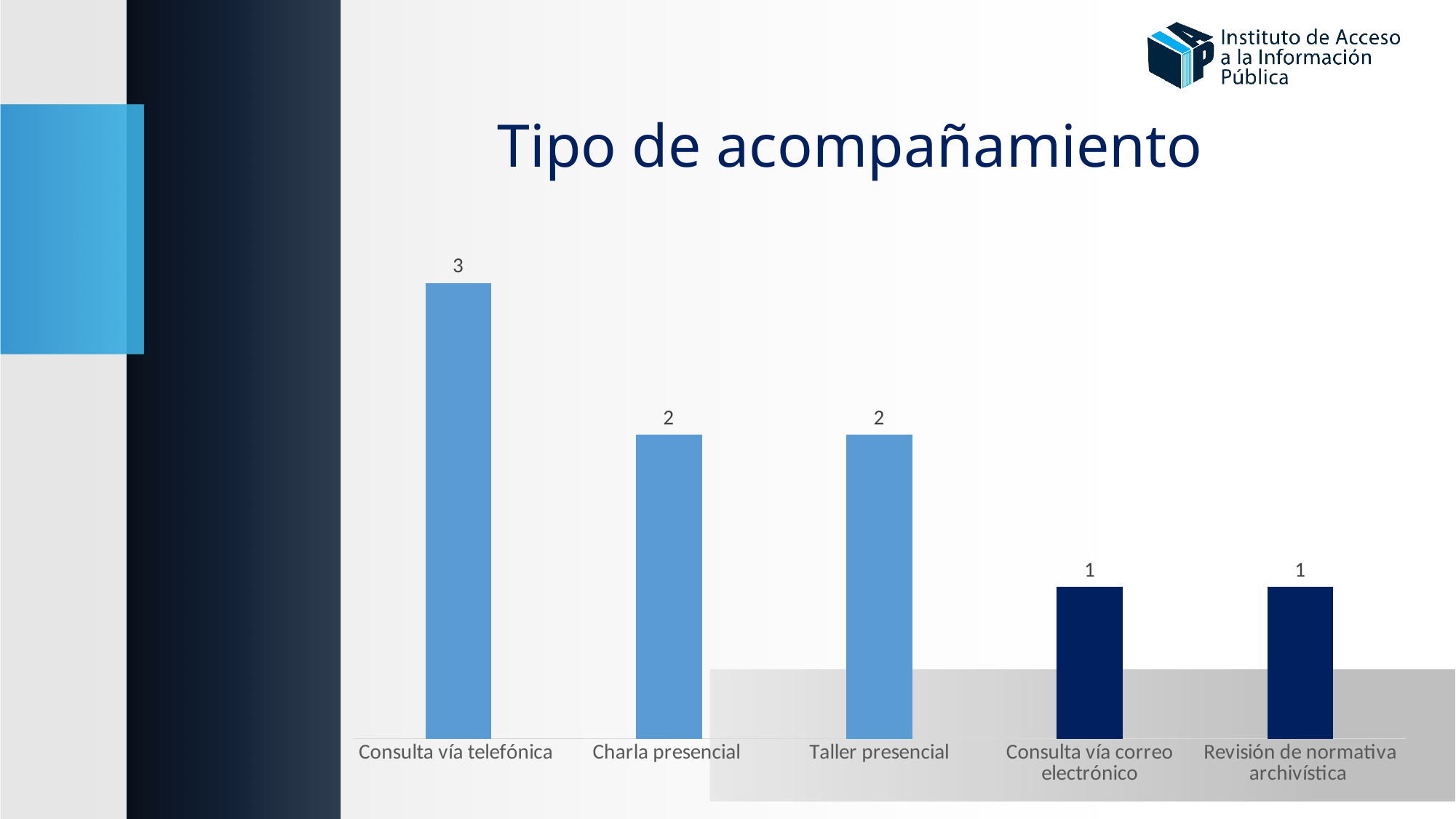
What is the value for Revisión de normativa archivística? 1 What is the difference between the values for Consulta vía telefónica and Revisión de normativa archivística? 2 What is the value for Consulta vía telefónica? 3 What is the value for Charla presencial? 2 Which category has the highest value? Consulta vía telefónica What is the value for Taller presencial? 2 Which is larger, the value for Taller presencial or the value for Consulta vía correo electrónico? Taller presencial How many categories are shown in the chart? 5 What is the title of the chart? Tipo de acompañamiento What is the difference between the values for Consulta vía telefónica and Charla presencial? 1 What kind of chart is shown on the slide? Bar chart What is the value for Consulta vía correo electrónico? 1